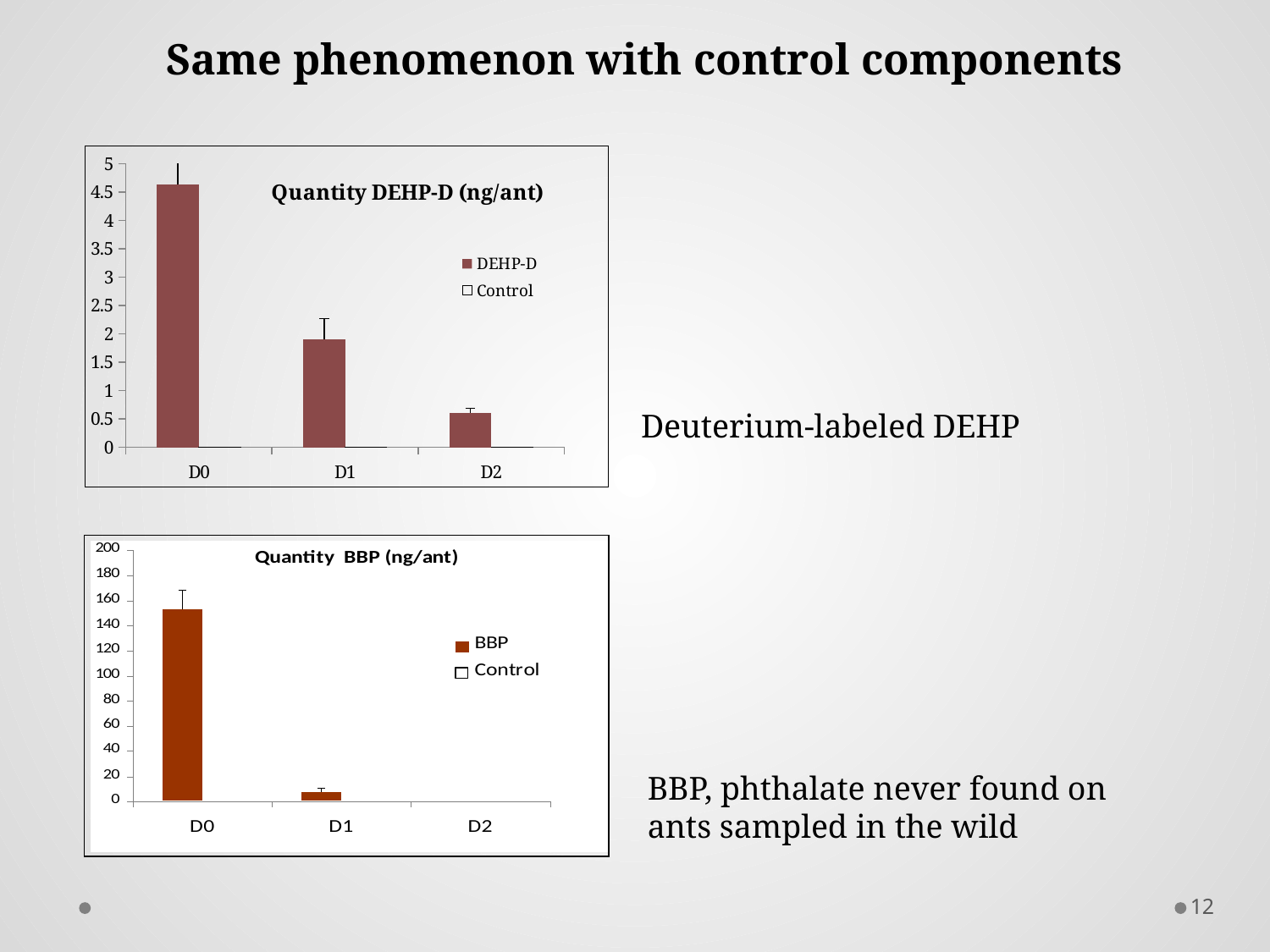
In the 'Quantity BBP (ng/ant)' chart, what are the two series listed in the legend? BBP and Control In the 'Quantity DEHP-D (ng/ant)' chart, is the DEHP-D value for D0 greater or less than 4? greater In the 'Quantity DEHP-D (ng/ant)' chart, is the DEHP-D value for D1 greater or less than 2.5? less In the 'Quantity DEHP-D (ng/ant)' chart, how many categories are shown on the x axis? 3 In the 'Quantity DEHP-D (ng/ant)' chart, do the DEHP-D values rise or fall from D0 to D2? fall In the 'Quantity DEHP-D (ng/ant)' chart, how many series does the legend list? 2 In the 'Quantity BBP (ng/ant)' chart, which is larger, the BBP value for D1 or for D0? D0 In the 'Quantity BBP (ng/ant)' chart, is the BBP value for D0 greater or less than 140? greater In the 'Quantity BBP (ng/ant)' chart, which category has the highest BBP value? D0 What kind of chart is the 'Quantity DEHP-D (ng/ant)' chart? bar chart In the 'Quantity DEHP-D (ng/ant)' chart, which category has the lowest DEHP-D value? D2 In the 'Quantity DEHP-D (ng/ant)' chart, which category has the highest DEHP-D value? D0